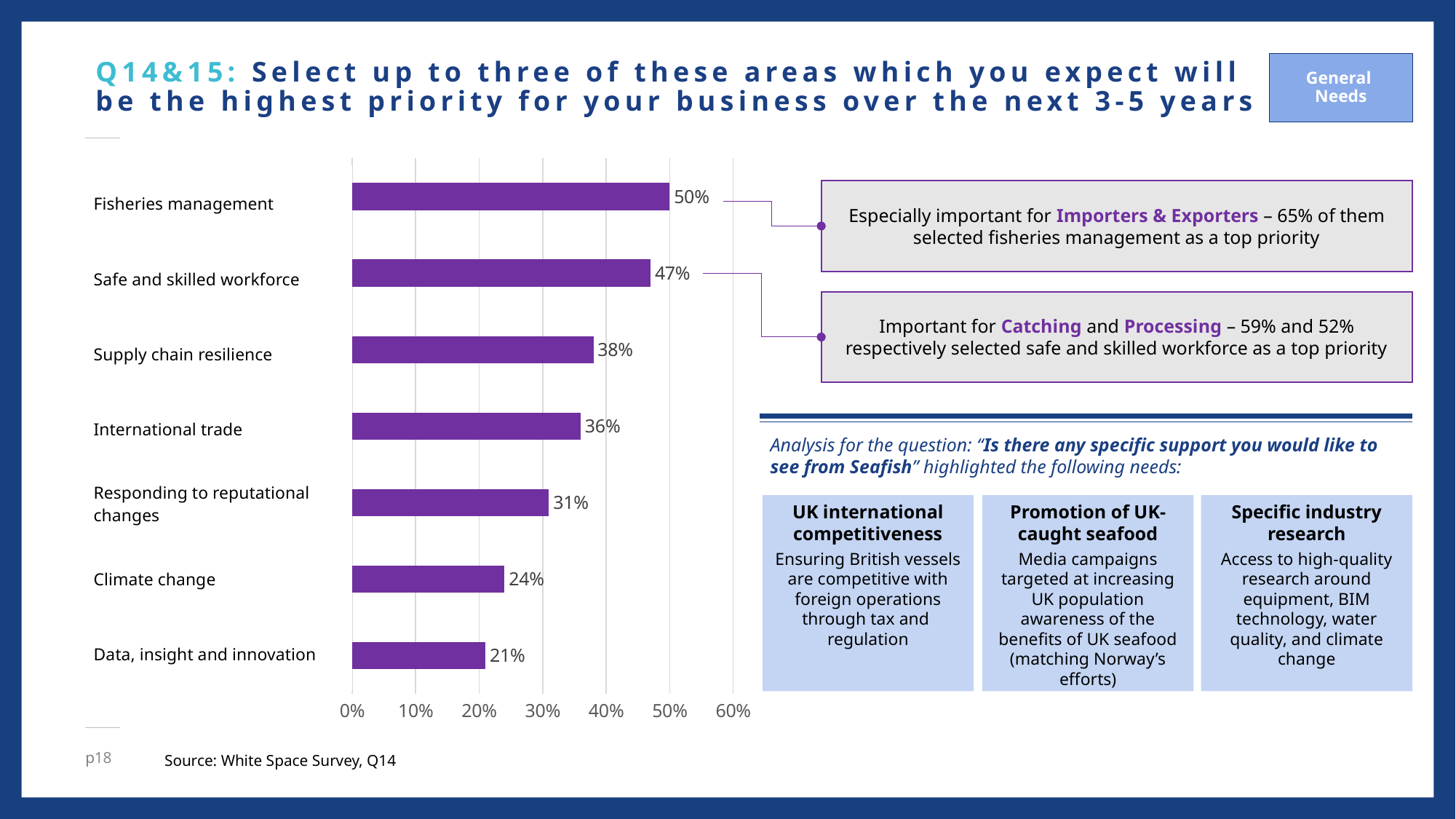
What is the difference in percentage points between Fisheries management and Safe and skilled workforce? 3 percentage points What percentage of respondents selected Fisheries management as a top priority? 50% How many areas (categories) are shown in the chart? 7 What type of chart is used on this slide? Bar chart What percentage is shown for Climate change? 24% What is the source cited for the chart data? White Space Survey, Q14 What is the difference between the values for International trade and Data, insight and innovation? 15 percentage points Which area has the highest percentage in the chart? Fisheries management Which area has the lowest percentage in the chart? Data, insight and innovation Which has a higher value: Supply chain resilience or International trade? Supply chain resilience What is the value shown for Supply chain resilience? 38% Is the value for Responding to reputational changes greater or less than 40%? less